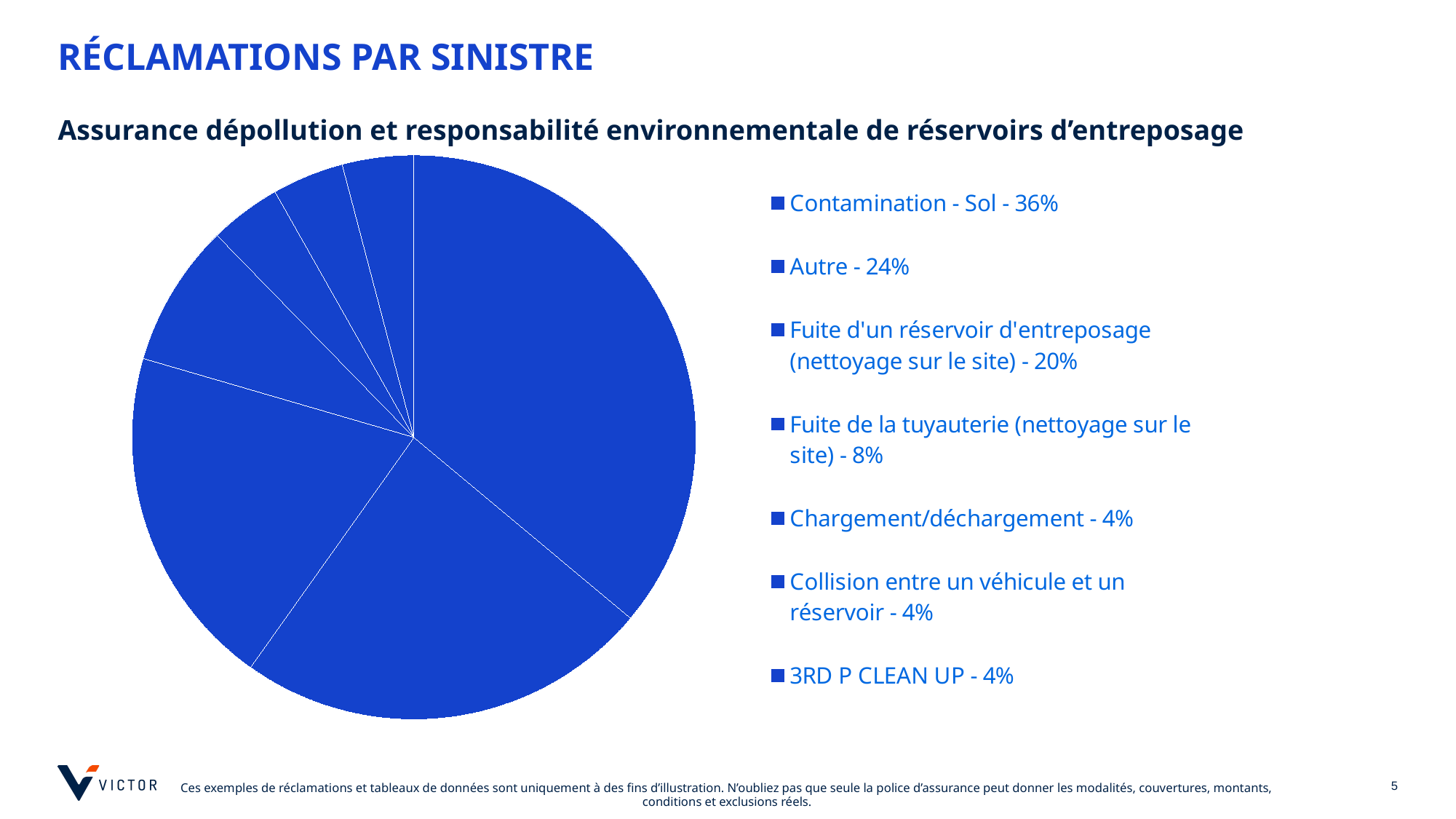
What is the combined share of Chargement/déchargement, Collision entre un véhicule et un réservoir, and 3RD P CLEAN UP? 12% What share of claims is attributed to Fuite de la tuyauterie (nettoyage sur le site)? 8% How many categories does the legend list? 7 What is the difference in share between Contamination - Sol and Autre? 12% What kind of chart is shown on the slide? pie chart What is the title of the chart on the slide? RÉCLAMATIONS PAR SINISTRE Which category has the largest share of the pie? Contamination - Sol What share of claims is attributed to Autre? 24% What share of claims is attributed to Contamination - Sol? 36% What is the difference in share between Fuite d'un réservoir d'entreposage (nettoyage sur le site) and Fuite de la tuyauterie (nettoyage sur le site)? 12% Which has a larger share, Autre or Fuite d'un réservoir d'entreposage (nettoyage sur le site)? Autre